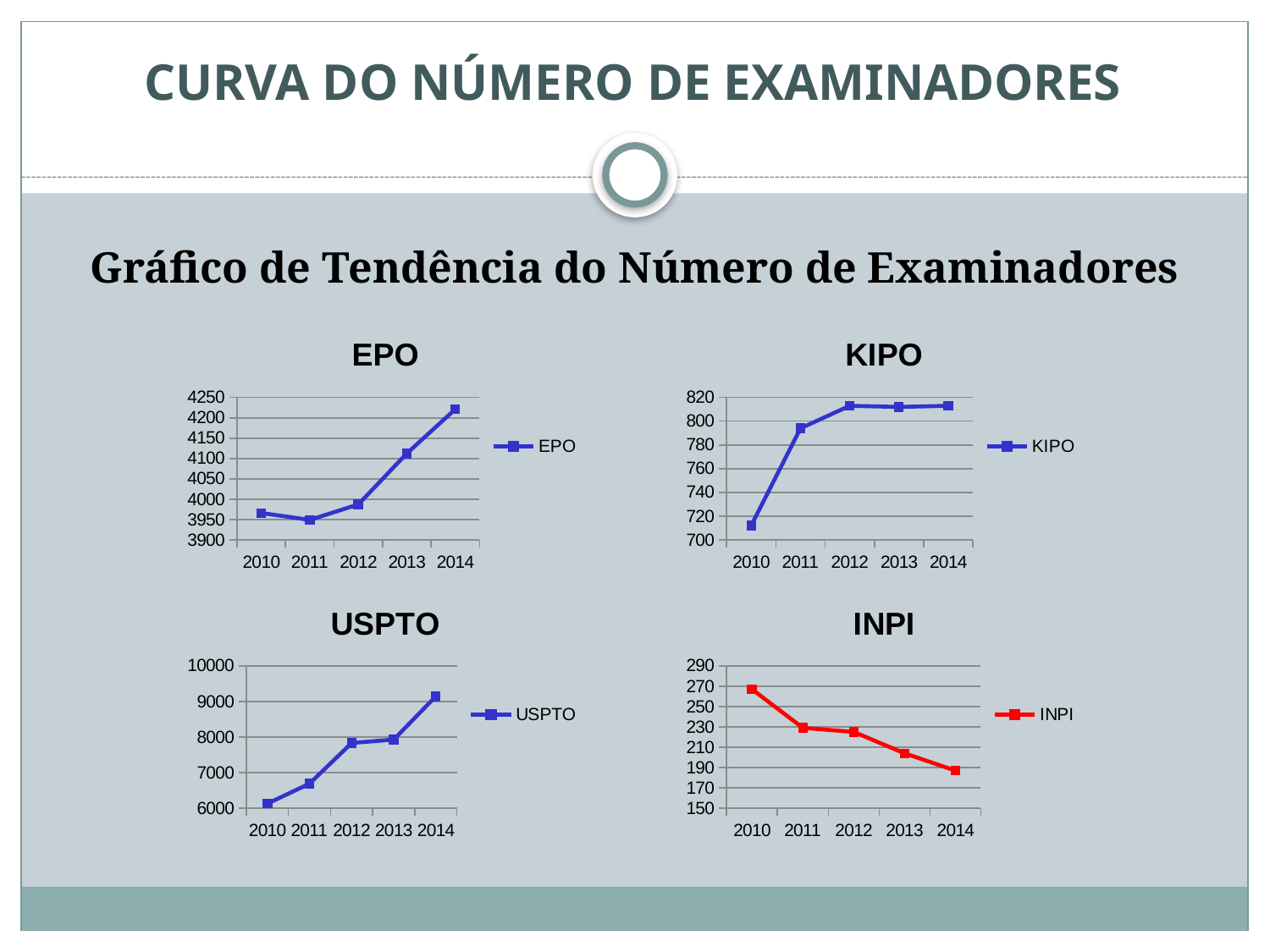
What colour is the line on the INPI chart? red On the USPTO chart, do the values rise or fall from 2010 to 2014? rise On the INPI chart, which is larger, the value for 2011 or the value for 2014? 2011 On the KIPO chart, which year has the lowest value? 2010 On the USPTO chart, is the value for 2014 greater or less than 9000? greater How many years are plotted on the USPTO chart? 5 What kind of chart is the EPO chart? line chart On the INPI chart, which year has the highest value? 2010 On the INPI chart, do the values rise or fall from 2010 to 2014? fall On the EPO chart, which year has the highest value? 2014 How many series does the legend of the KIPO chart list? 1 On the KIPO chart, is the value for 2010 greater or less than 720? less